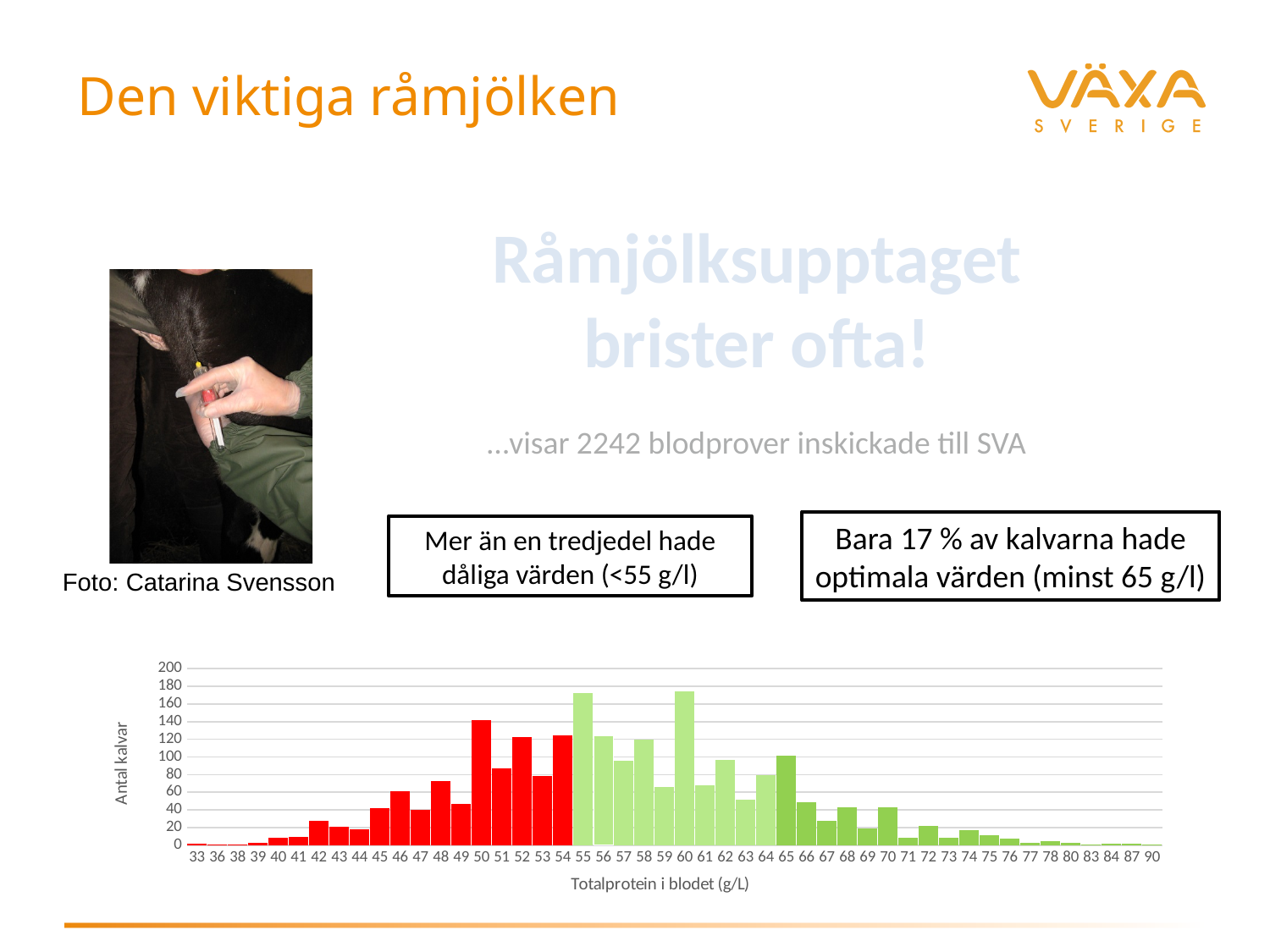
Which has the larger value, 65 g/L or 66 g/L? 65 Do the values generally rise or fall along the x axis from 65 g/L to 90 g/L? fall What is the title of the x axis of the chart? Totalprotein i blodet (g/L) Is the value for 50 g/L greater or less than 120? greater Is the value for 45 g/L greater or less than 60? less Is the value for 60 g/L greater or less than 160? greater Which has the larger value, 50 g/L or 51 g/L? 50 What kind of chart is shown on the slide? bar chart What is the title of the y axis of the chart? Antal kalvar Which has the larger value, 60 g/L or 61 g/L? 60